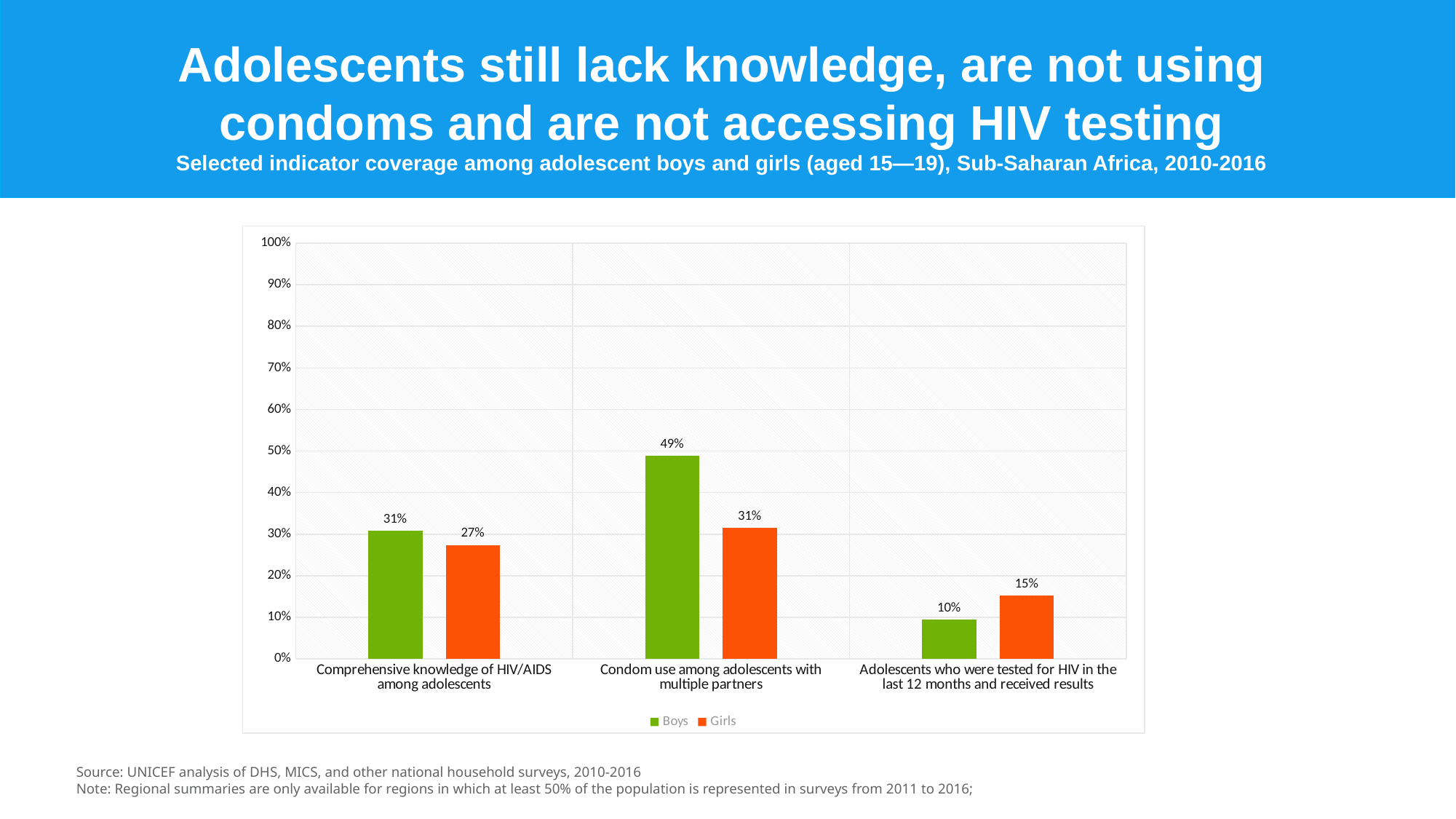
Which category has the lowest value for Girls? Adolescents who were tested for HIV in the last 12 months and received results How many series does the legend list? 2 What kind of chart is shown on the slide? Bar chart What is the value for Girls for 'Adolescents who were tested for HIV in the last 12 months and received results'? 15% What is the difference between the Boys and Girls values for 'Condom use among adolescents with multiple partners'? 18% Which category has the highest value for Boys? Condom use among adolescents with multiple partners What is the value for Boys for 'Comprehensive knowledge of HIV/AIDS among adolescents'? 31% For 'Adolescents who were tested for HIV in the last 12 months and received results', which is larger, Boys or Girls? Girls How many categories are shown on the x axis? 3 What is the value for Girls for 'Condom use among adolescents with multiple partners'? 31% Is the Boys value for 'Condom use among adolescents with multiple partners' greater or less than 40%? greater What is the value for Boys for 'Adolescents who were tested for HIV in the last 12 months and received results'? 10%